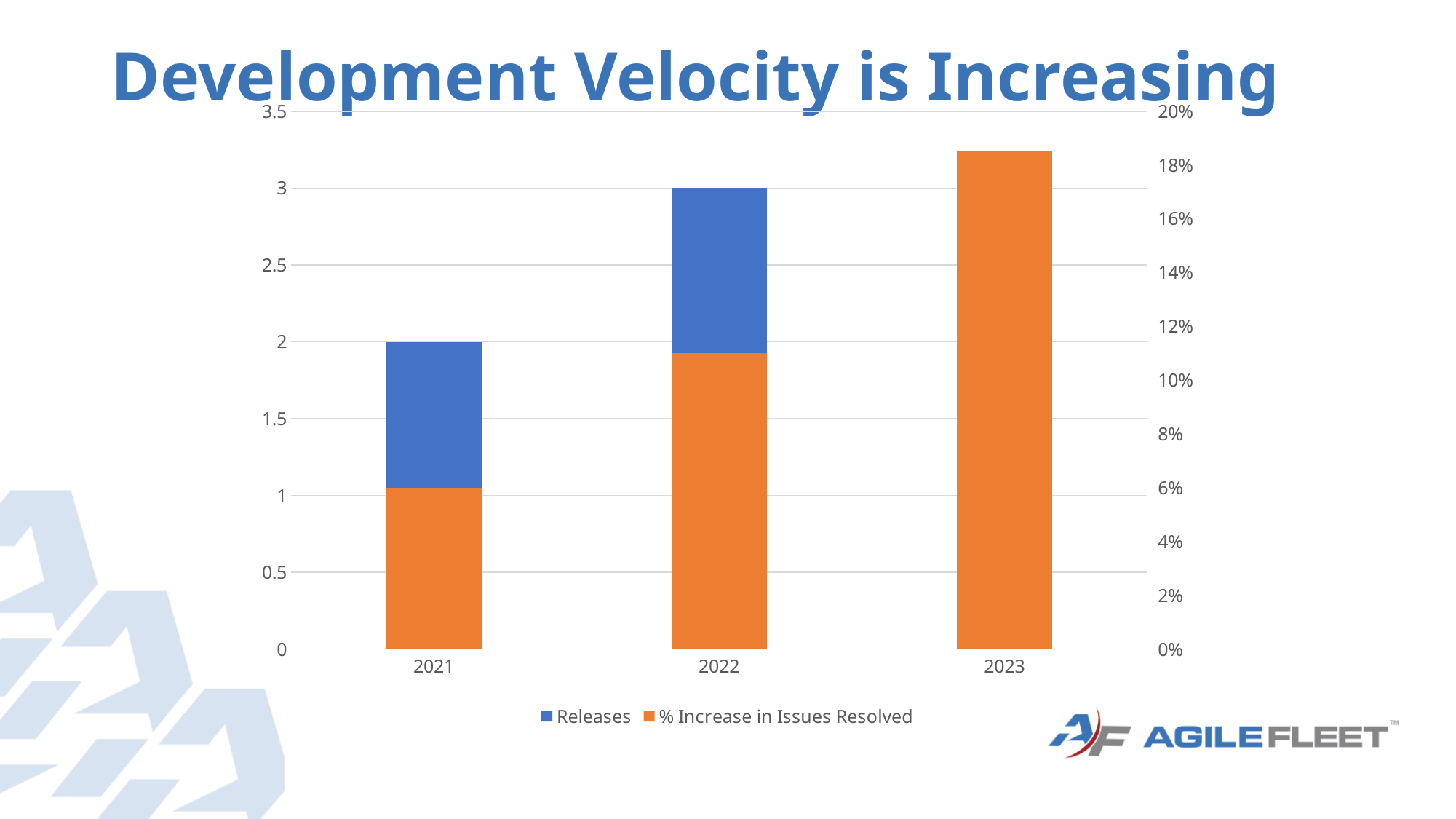
How many series does the legend list? 2 How many years are shown on the x axis? 3 What is the value of Releases for 2021? 2 What is the % Increase in Issues Resolved for 2021? 6% What kind of chart is shown on the slide? bar chart Does the % Increase in Issues Resolved rise or fall from 2021 to 2023? rise By how much did Releases increase from 2021 to 2022? 1 Is the % Increase in Issues Resolved for 2022 greater or less than 10%? greater Is the % Increase in Issues Resolved for 2023 greater or less than 16%? greater Which year has the highest % Increase in Issues Resolved? 2023 What is the value of Releases for 2022? 3 Which year has the lowest % Increase in Issues Resolved? 2021